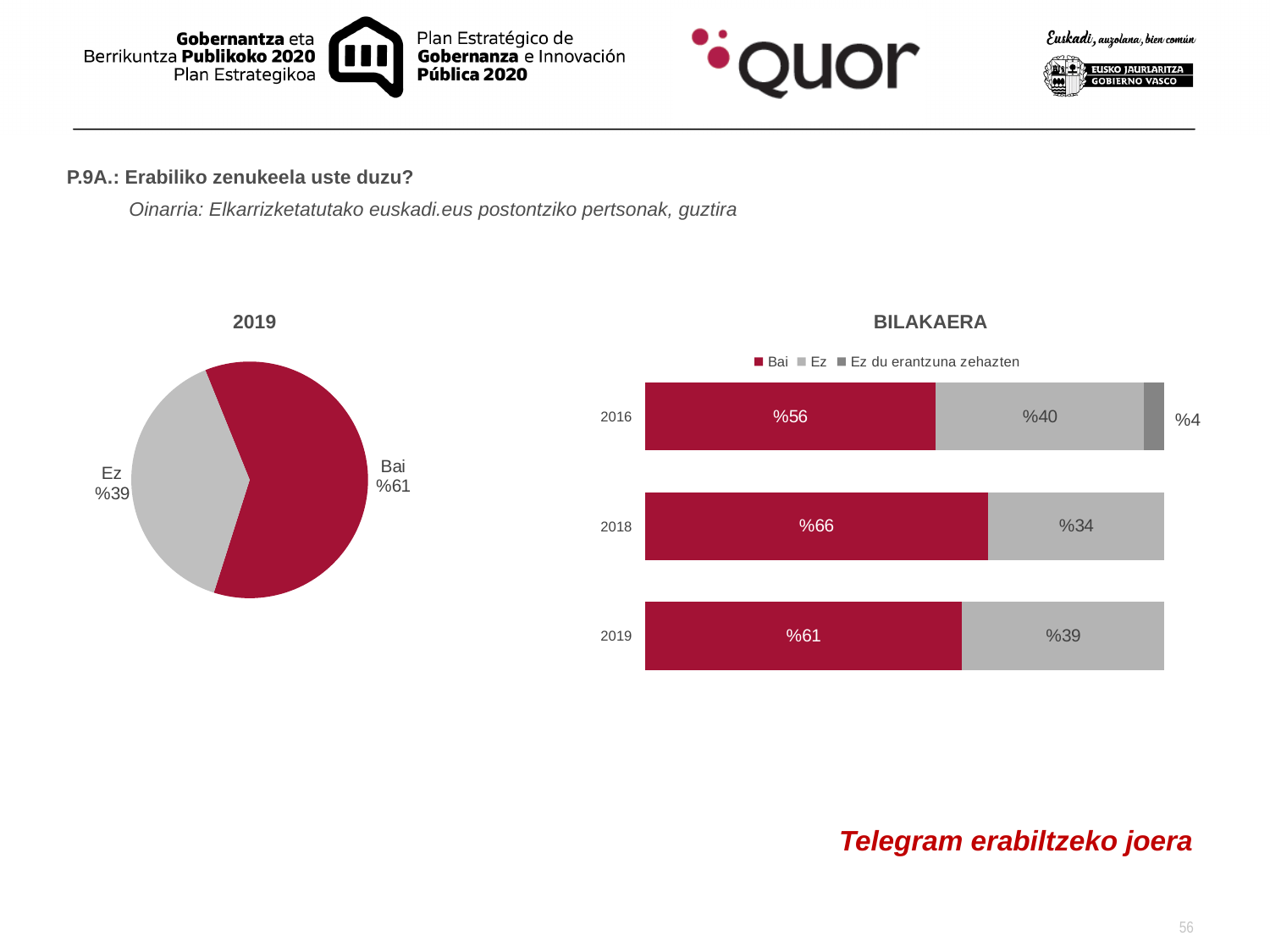
In the BILAKAERA chart, how many series does the legend list? 3 In the BILAKAERA chart, which year has the highest Bai value? 2018 In the BILAKAERA chart, what is the Bai value for 2016? %56 In the pie chart titled 2019, what is the value for Ez? %39 In the BILAKAERA chart, what is the value for Ez du erantzuna zehazten in 2016? %4 In the pie chart titled 2019, which slice is larger, Bai or Ez? Bai What kind of chart is the BILAKAERA chart? stacked bar chart In the BILAKAERA chart, what is the difference between the Bai values for 2018 and 2016? %10 In the BILAKAERA chart, what is the Ez value for 2018? %34 In the pie chart titled 2019, how many slices are there? 2 In the pie chart titled 2019, what is the value for Bai? %61 What kind of chart is the chart titled 2019 on the left? pie chart